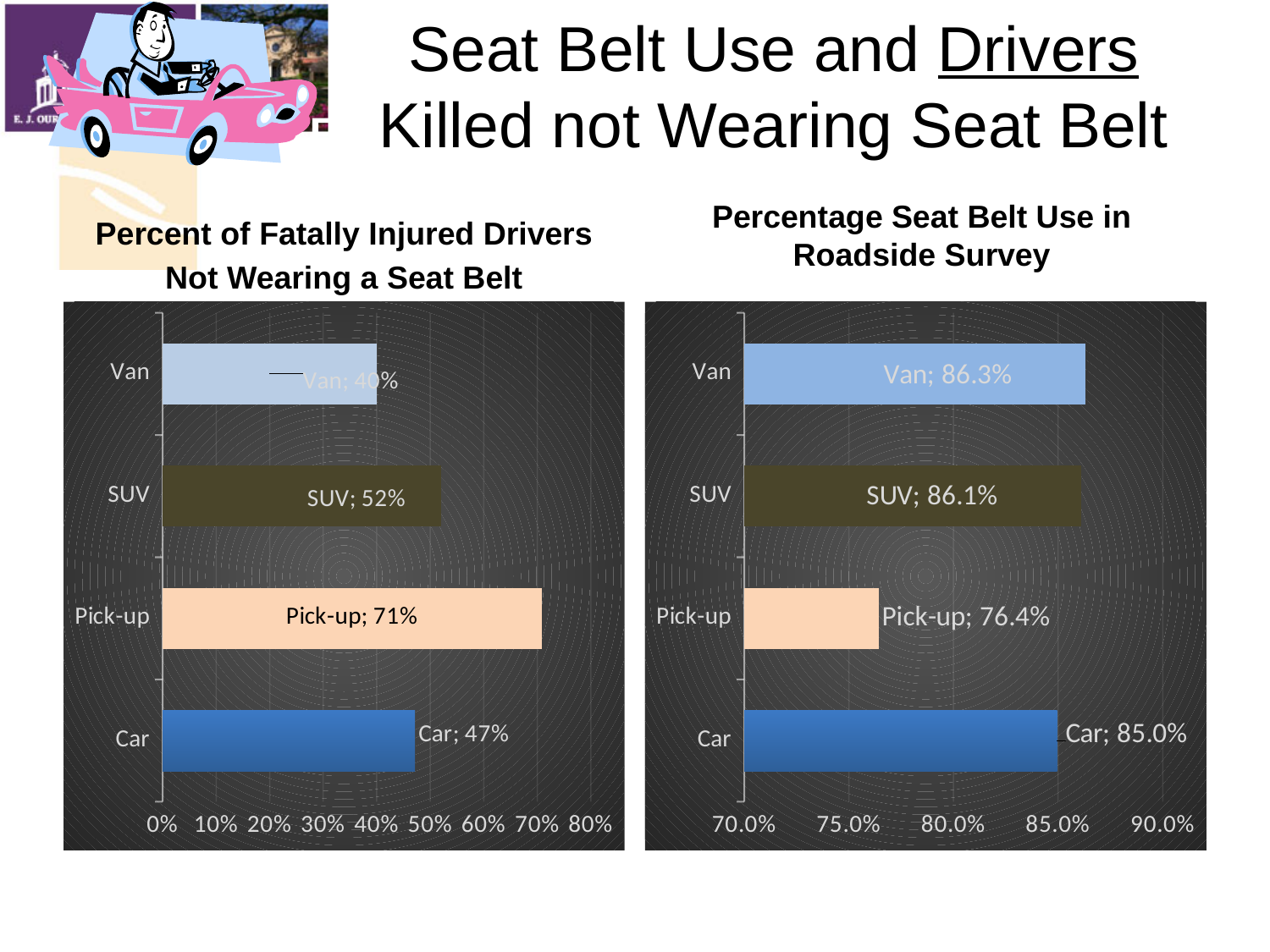
In the 'Percentage Seat Belt Use in Roadside Survey' chart, what is the value for Pick-up? 76.4% How many vehicle categories are shown in the 'Percent of Fatally Injured Drivers Not Wearing a Seat Belt' chart? 4 In the 'Percent of Fatally Injured Drivers Not Wearing a Seat Belt' chart, what is the difference between the Pick-up and SUV values? 19% In the 'Percent of Fatally Injured Drivers Not Wearing a Seat Belt' chart, which vehicle type has the lowest value? Van In the 'Percentage Seat Belt Use in Roadside Survey' chart, what is the value for Van? 86.3% What type of chart is the 'Percentage Seat Belt Use in Roadside Survey' chart? Bar chart In the 'Percent of Fatally Injured Drivers Not Wearing a Seat Belt' chart, what is the value for Car? 47% In the 'Percent of Fatally Injured Drivers Not Wearing a Seat Belt' chart, what is the value for Pick-up? 71% In the 'Percent of Fatally Injured Drivers Not Wearing a Seat Belt' chart, which vehicle type has the highest value? Pick-up In the 'Percentage Seat Belt Use in Roadside Survey' chart, is the value for Car greater or less than 80.0%? greater In the 'Percentage Seat Belt Use in Roadside Survey' chart, which vehicle type has the lowest seat belt use? Pick-up In the 'Percentage Seat Belt Use in Roadside Survey' chart, what is the difference between the Car and Pick-up values? 8.6%